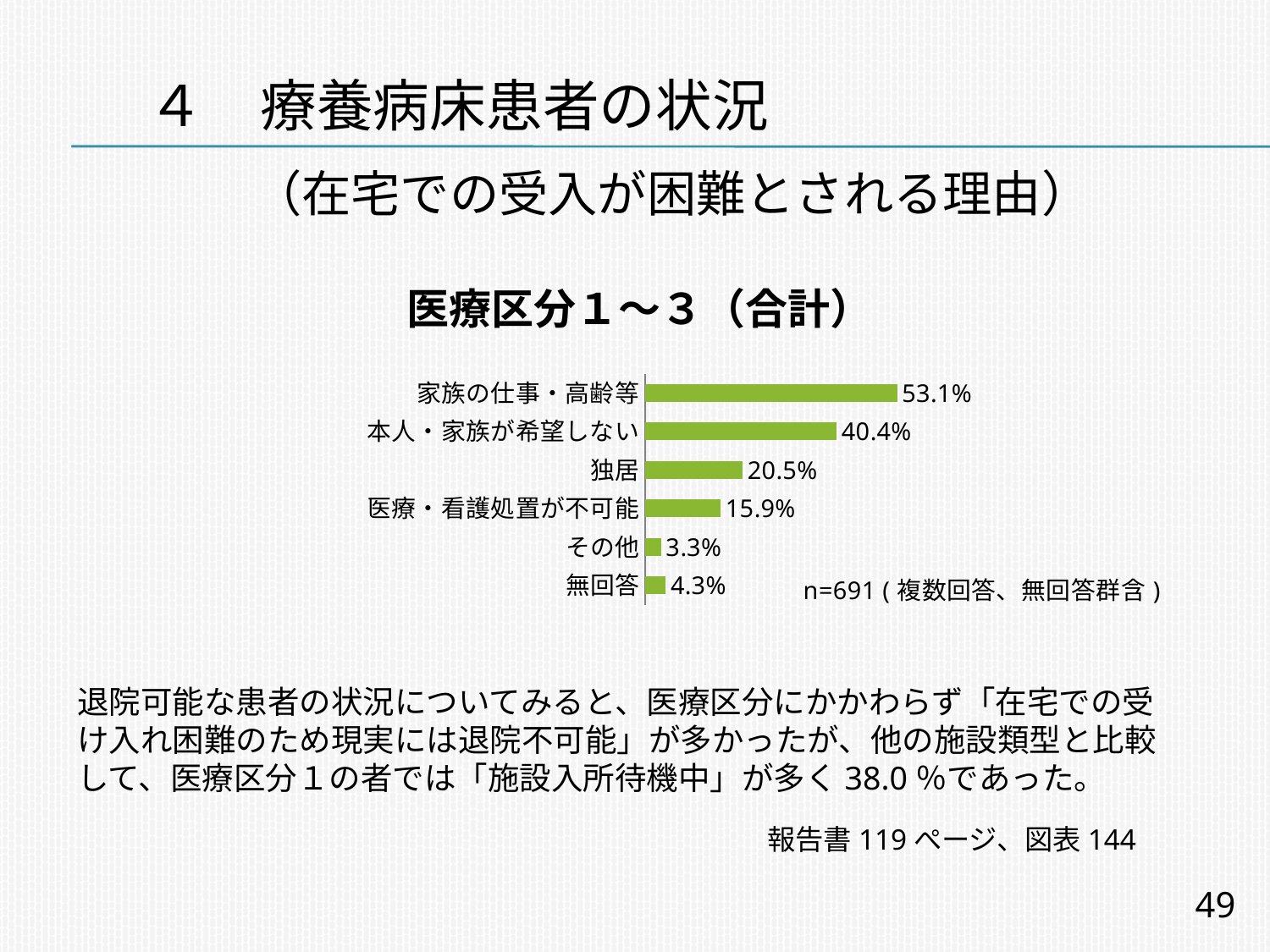
What is the difference between the values for 家族の仕事・高齢等 and 本人・家族が希望しない? 12.7% What is the title of the chart? 医療区分１～３（合計） What is the value for 本人・家族が希望しない? 40.4% How many categories are shown in the chart? 6 What is the value for 医療・看護処置が不可能? 15.9% What is the value for 家族の仕事・高齢等? 53.1% Which is larger, the value for 独居 or the value for 医療・看護処置が不可能? 独居 Which category has the highest value? 家族の仕事・高齢等 What is the value for 独居? 20.5% What is the value for 無回答? 4.3% What kind of chart is shown on the slide? Bar chart Which category has the lowest value? その他